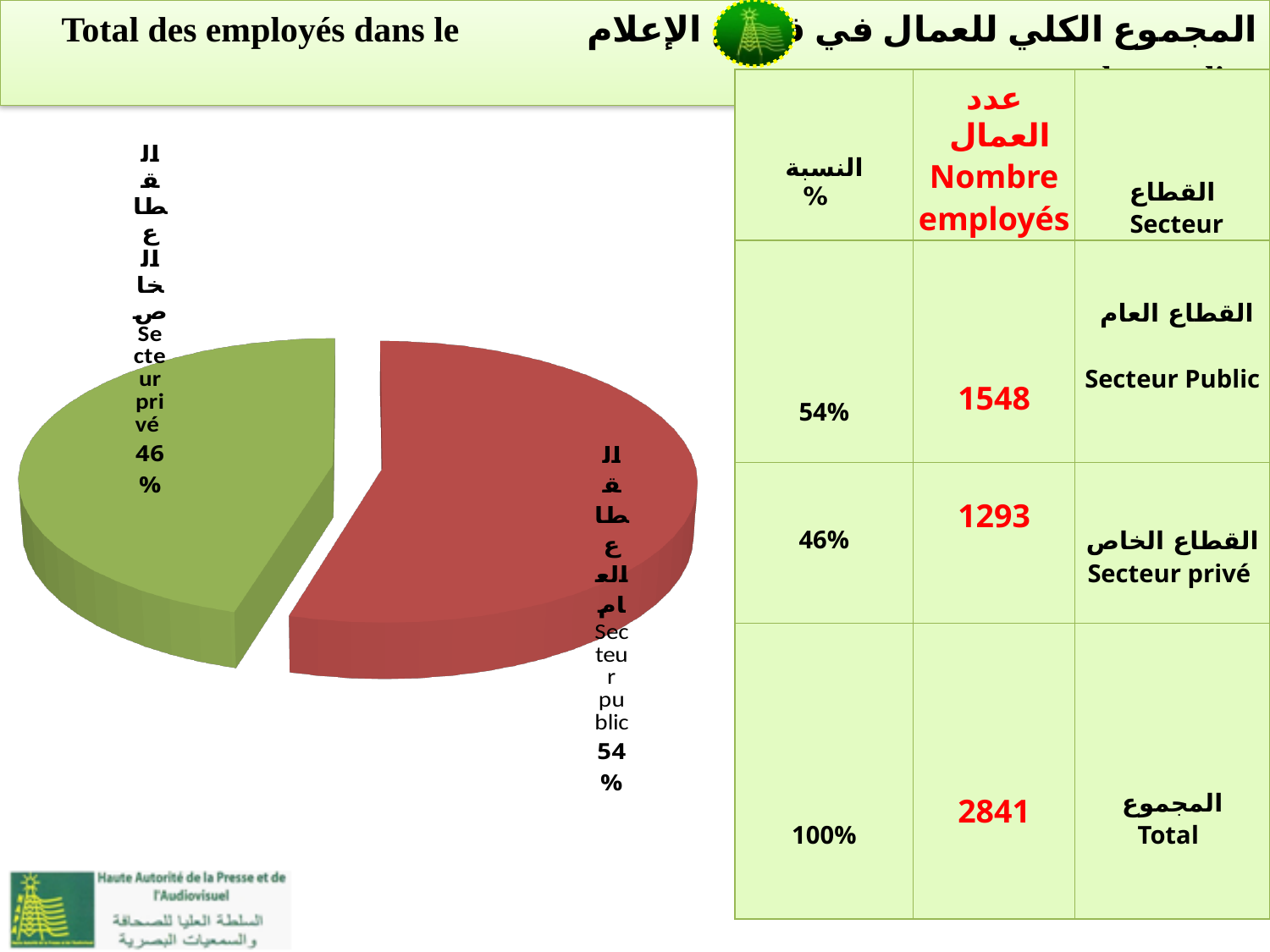
What share of the pie does Secteur privé represent? 46% How many slices does the pie chart have? 2 What is the difference in percentage points between the Secteur public and Secteur privé slices? 8 Is the share for Secteur privé greater or less than 50%? less What colour is the Secteur public slice in the pie chart? red What colour is the Secteur privé slice in the pie chart? green Which is larger in the pie chart, Secteur public or Secteur privé? Secteur public Which slice of the pie chart is the largest? Secteur public What share of the pie does Secteur public represent? 54% Which slice of the pie chart is the smallest? Secteur privé What kind of chart is shown on the slide? pie chart